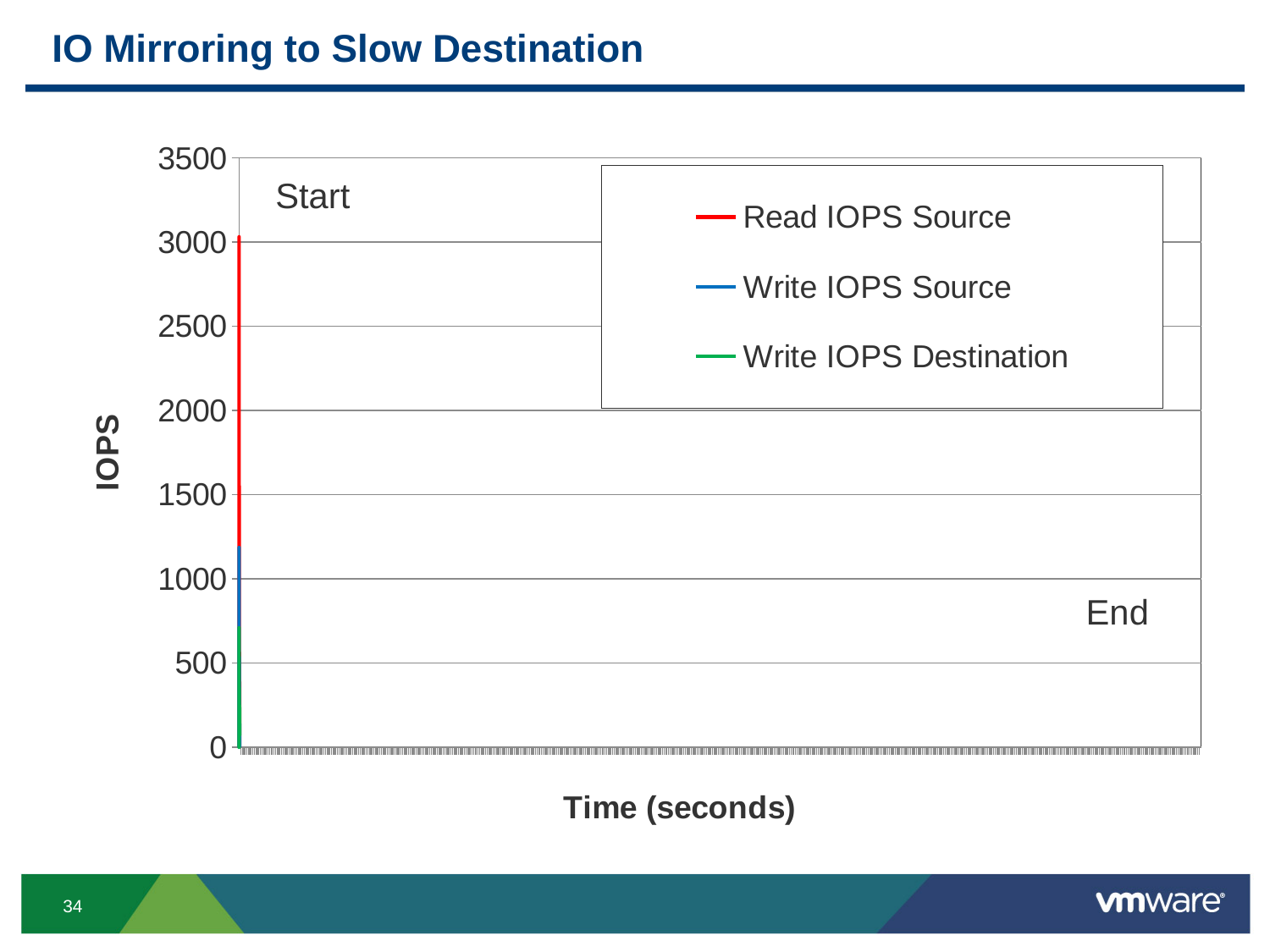
Which reaches a higher peak value, Read IOPS Source or Write IOPS Destination? Read IOPS Source What is the label on the x axis? Time (seconds) Which series reaches the highest IOPS value on the chart? Read IOPS Source Is the peak value for Read IOPS Source greater or less than 2500? greater What is the label on the y axis? IOPS Is the peak value for Write IOPS Source greater or less than 1500? less Is the peak value for Write IOPS Destination greater or less than 1000? less Which reaches a higher peak value, Write IOPS Source or Write IOPS Destination? Write IOPS Source What kind of chart is shown on the slide? line chart How many series does the legend list? 3